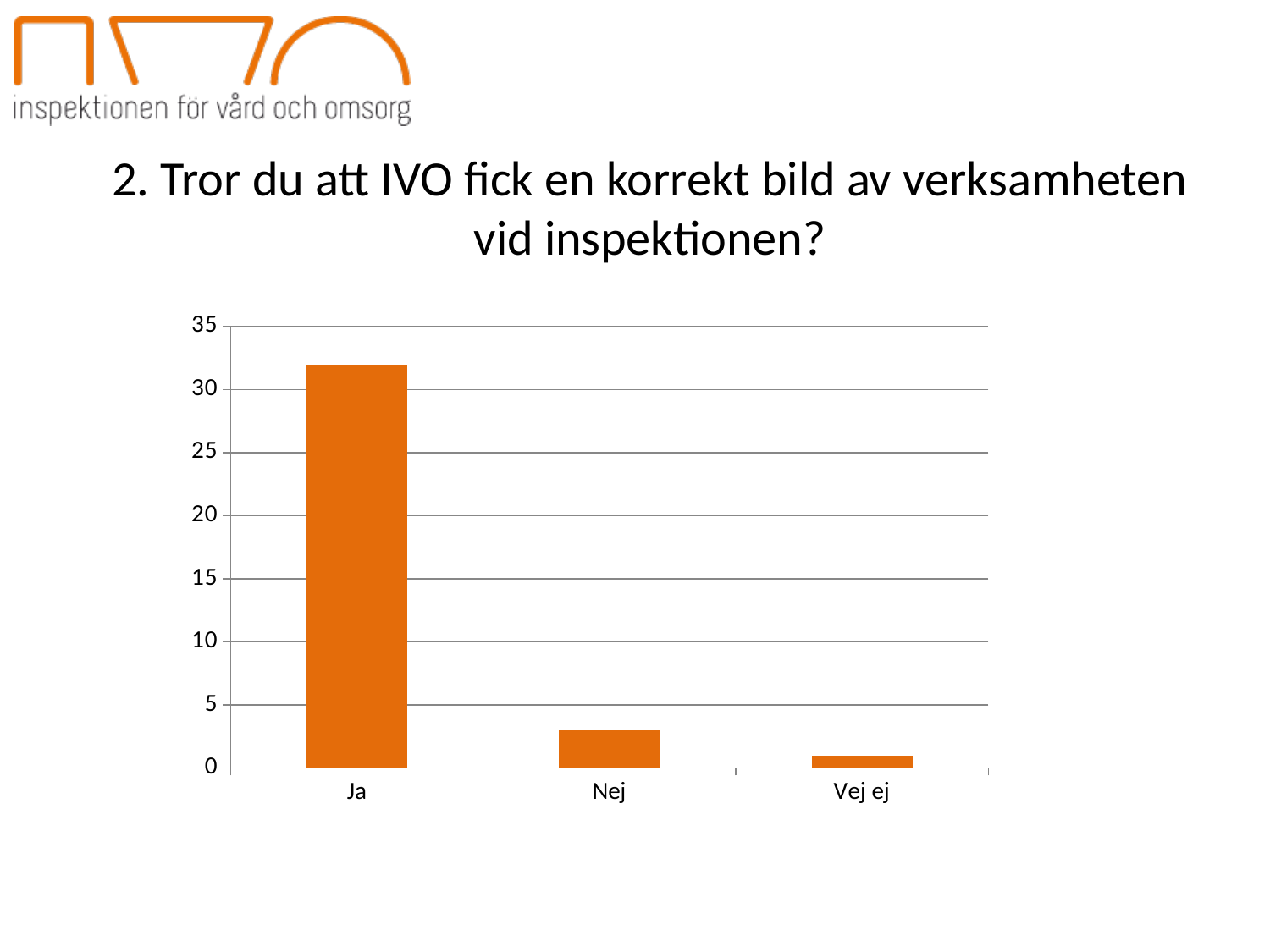
Which is larger, the value for Ja or the value for Nej? Ja Is the value for Vej ej greater or less than 5? less Which category has the lowest value in the chart? Vej ej Which is larger, the value for Nej or the value for Vej ej? Nej Is the value for Ja greater or less than 30? greater Is the value for Nej greater or less than 5? less Which category has the highest value in the chart? Ja How many categories are shown on the x axis of the chart? 3 What colour are the bars in the chart? orange What kind of chart is shown on the slide? bar chart What is the highest value shown on the y axis of the chart? 35